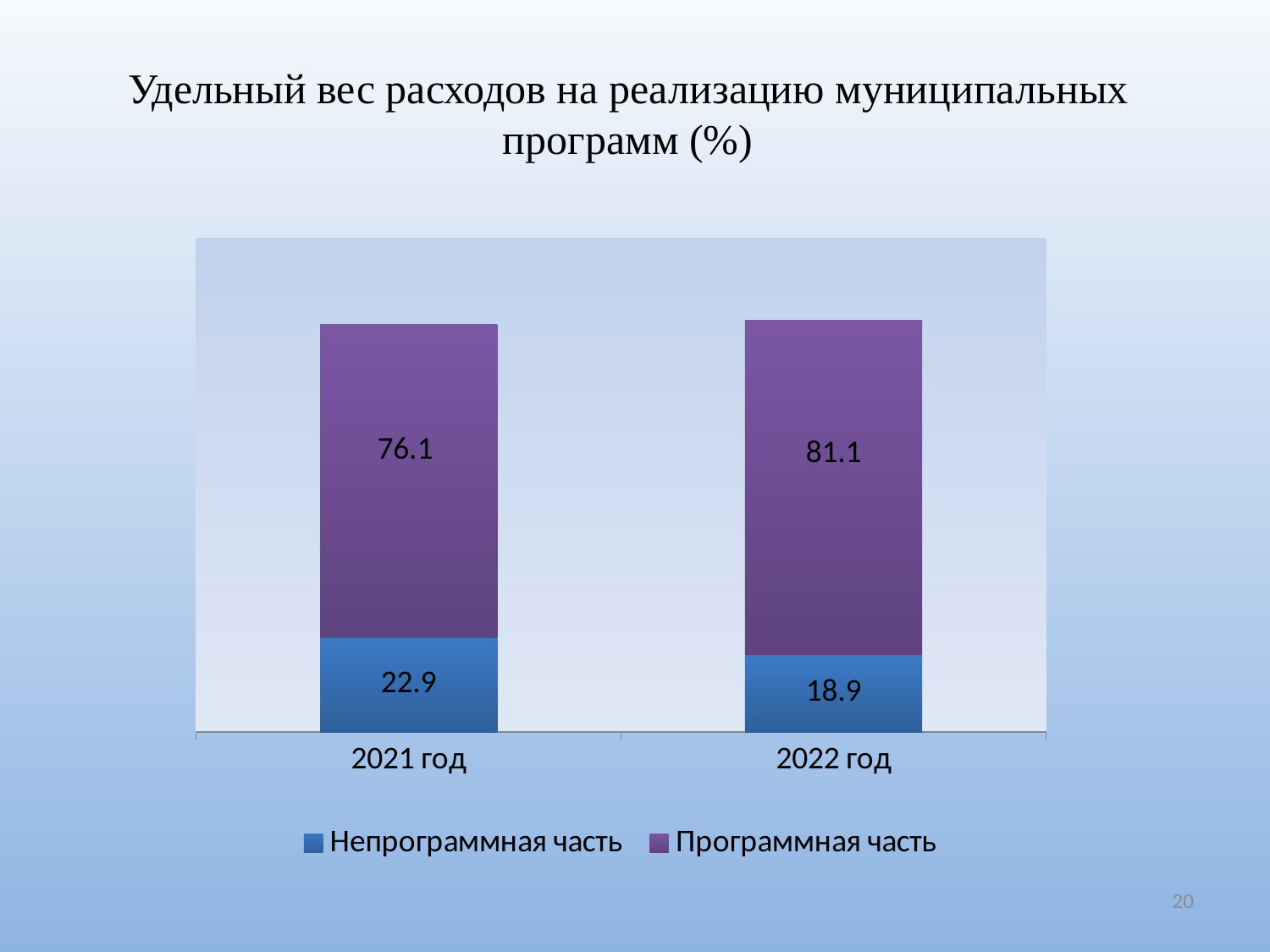
What is the difference between the Программная часть values for 2022 год and 2021 год? 5 What is the difference between the Непрограммная часть values for 2021 год and 2022 год? 4 Which year has the higher value for Программная часть? 2022 год What is the value of Программная часть for 2021 год? 76.1 What kind of chart is shown on the slide? stacked bar chart What is the value of Программная часть for 2022 год? 81.1 Which year has the lower value for Непрограммная часть? 2022 год How many categories are shown on the x axis? 2 What is the value of Непрограммная часть for 2022 год? 18.9 How many series does the legend list? 2 What is the value of Непрограммная часть for 2021 год? 22.9 Is the Непрограммная часть value for 2021 год larger or smaller than the Непрограммная часть value for 2022 год? larger